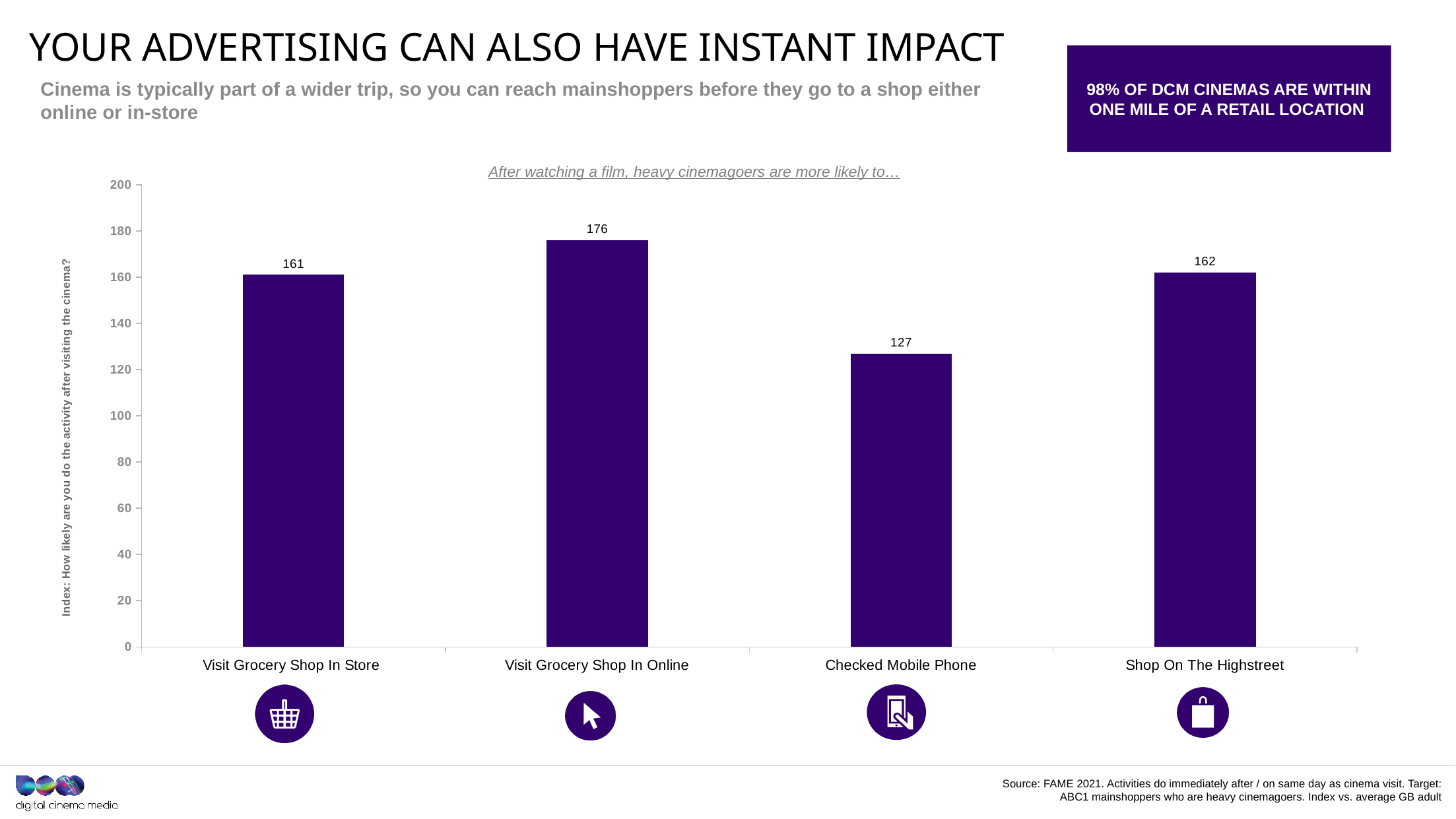
What is the difference between the index values for Visit Grocery Shop In Online and Checked Mobile Phone? 49 What is the index value for Visit Grocery Shop In Store? 161 Which is larger, the index value for Visit Grocery Shop In Online or for Shop On The Highstreet? Visit Grocery Shop In Online How many activities are shown in the chart? 4 What kind of chart is shown on the slide? bar chart Which activity has the lowest index value? Checked Mobile Phone Is the value for Checked Mobile Phone greater or less than 140? less What is the index value for Shop On The Highstreet? 162 Which activity has the highest index value? Visit Grocery Shop In Online What is the index value for Visit Grocery Shop In Online? 176 What is the index value for Checked Mobile Phone? 127 What is the title shown above the chart? After watching a film, heavy cinemagoers are more likely to…